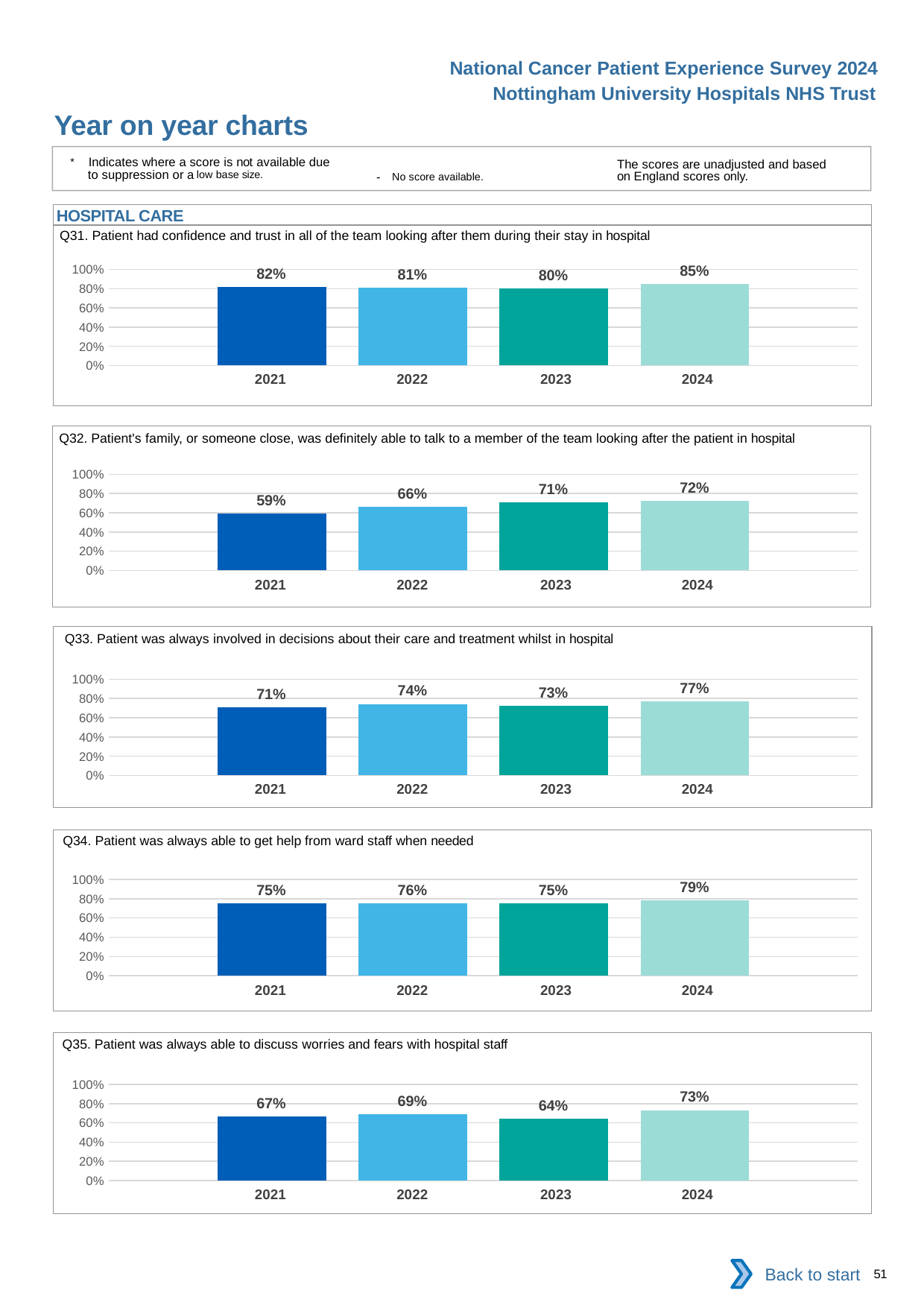
In the Q32 chart, what is the difference between the 2024 and 2021 values? 13% In the Q34 chart, which is larger, the value for 2022 or the value for 2024? 2024 In the Q33 chart, which year has the highest value? 2024 What kind of chart is the Q32 chart? Bar chart In the Q32 chart, do the values rise or fall from 2021 to 2024? Rise In the Q31 chart, what is the value for 2024? 85% In the Q32 chart, which year has the lowest value? 2021 How many years are shown in the Q31 chart? 4 In the Q33 chart, what is the value for 2022? 74% In the Q35 chart, which year has the lowest value? 2023 In the Q34 chart, what is the value for 2023? 75% In the Q35 chart, what is the difference between the 2024 and 2023 values? 9%